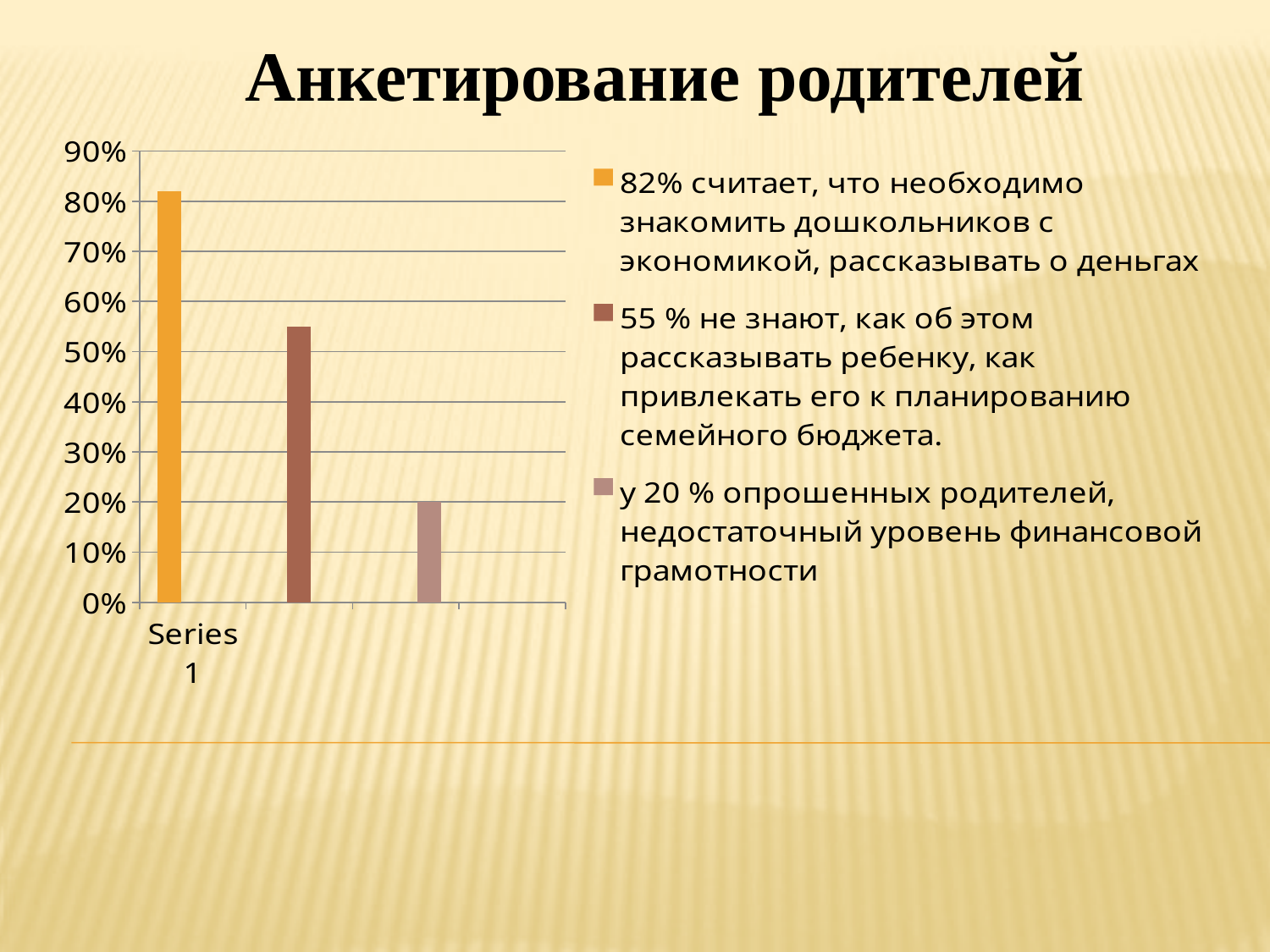
What value does the pink bar reach on the vertical axis? 20% How many bars are plotted in the chart? 3 How many entries does the legend (the bulleted list with coloured squares) list? 3 What is the title of the slide containing the chart? Анкетирование родителей What label appears on the horizontal axis under the first bar? Series 1 Is the value of the brown bar greater or less than 60%? less What kind of chart is shown on the slide? bar chart Which bar is the tallest in the chart: the orange, the brown or the pink one? the orange bar Which is larger, the value of the orange bar or the value of the brown bar? the orange bar Is the value of the pink bar greater or less than 30%? less Which bar is the shortest in the chart: the orange, the brown or the pink one? the pink bar Is the value of the orange bar greater or less than 80%? greater